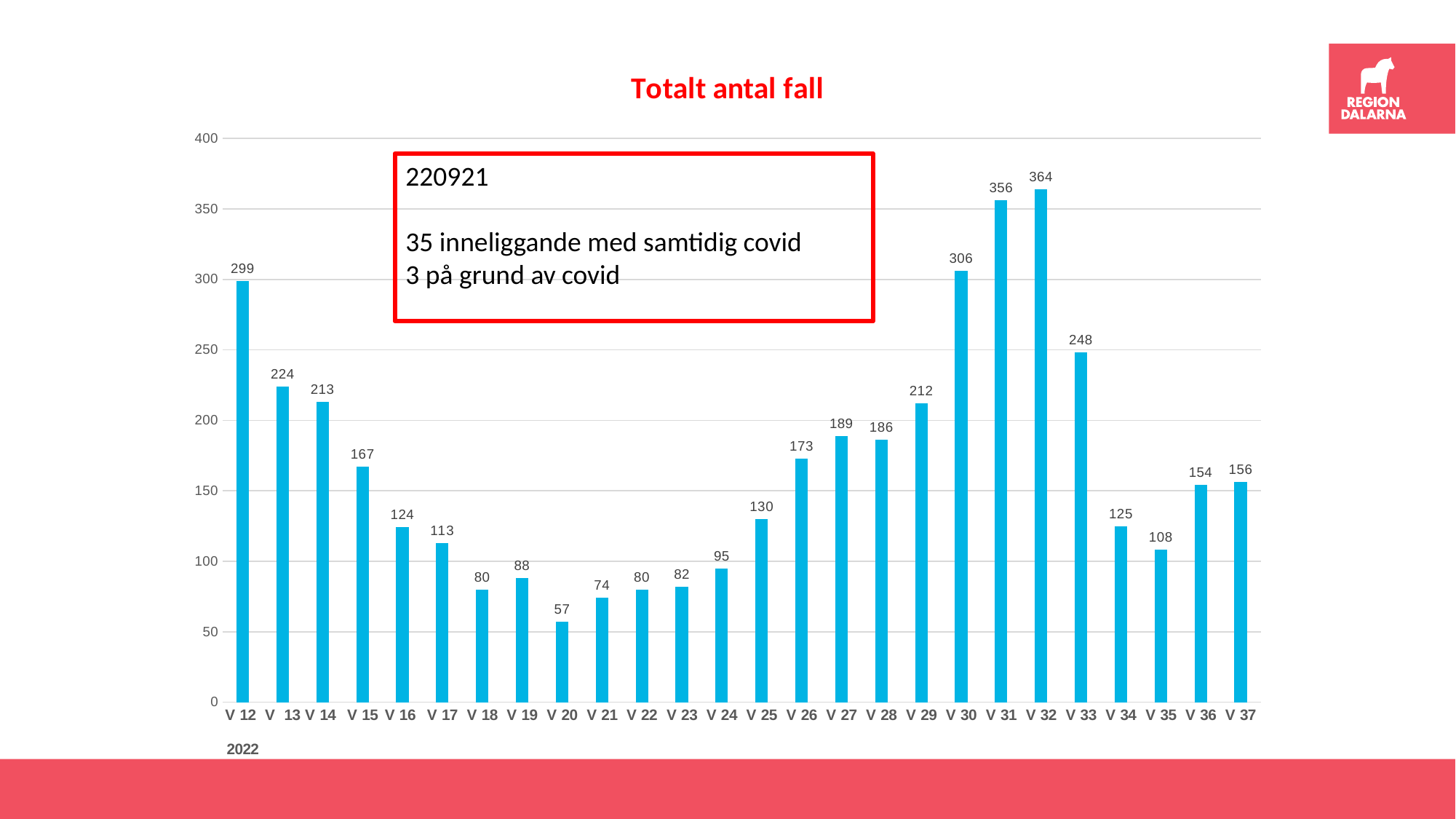
What is the difference between the values for V 12 and V 13? 75 What is the difference between the values for V 31 and V 30? 50 What is the value for V 32? 364 Which week has the lowest value? V 20 Which week has the highest value? V 32 What is the title of the chart? Totalt antal fall How many weeks are shown on the x axis? 26 Do the values rise or fall from V 20 to V 32? Rise What is the value for V 20? 57 What kind of chart is this? Bar chart What is the value for V 25? 130 Which is larger, the value for V 33 or the value for V 29? V 33